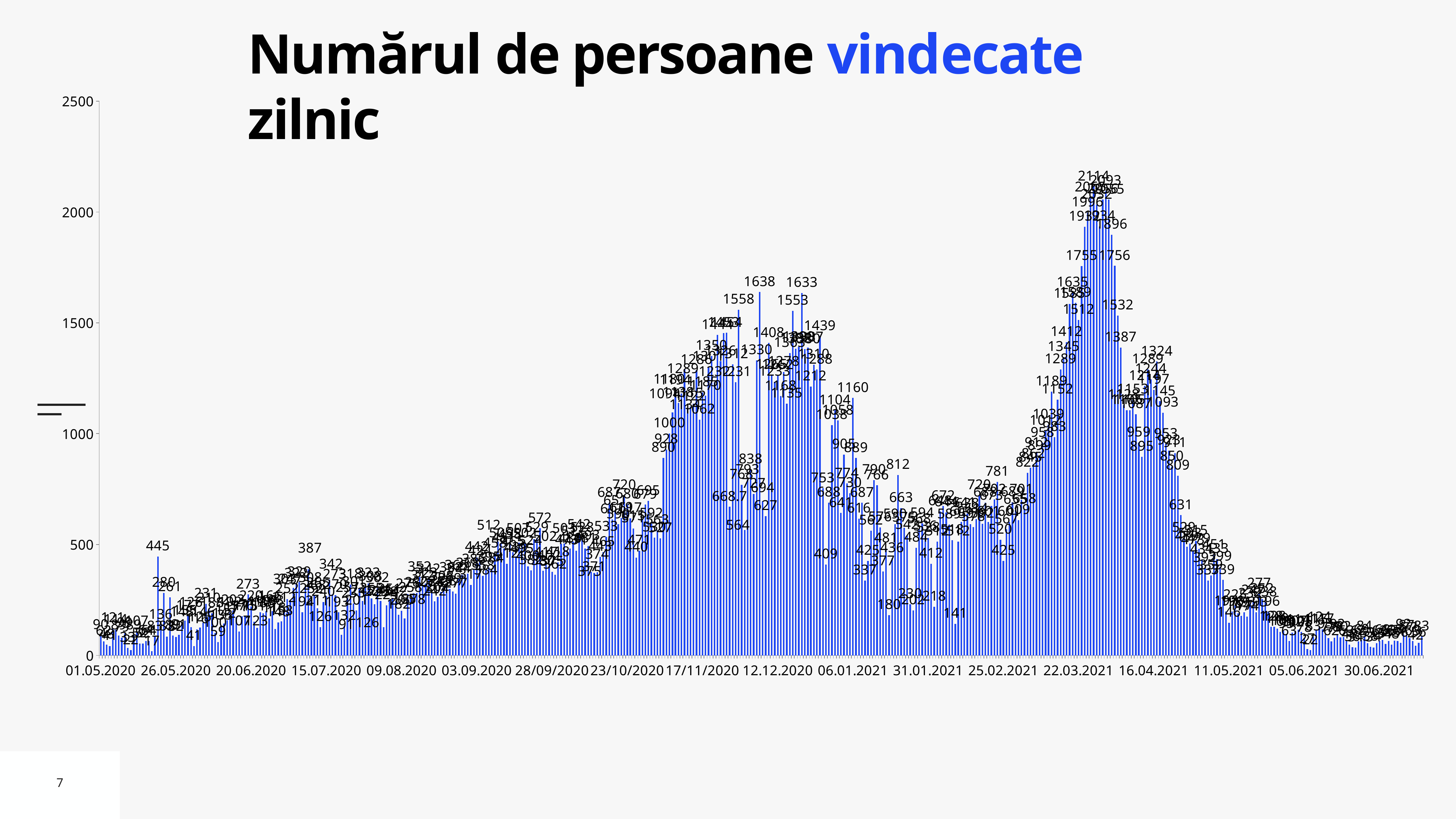
Is the highest bar on the chart greater or less than 2000? greater What is the difference between the peak value of 2114 and the December 2020 peak of 1638? 476 Is the value at 22.03.2021 greater or less than 1000? greater What kind of chart is shown on the slide? bar chart Is the value at 31.01.2021 greater or less than 1000? less Do the values generally rise or fall between 22.03.2021 and 05.06.2021? fall Do the values generally rise or fall between 01.05.2020 and 17/11/2020? rise What is the title of the chart? Numărul de persoane vindecate zilnic What is the highest value shown on the vertical axis? 2500 Which is larger, the bar labelled 1638 or the bar labelled 1633? 1638 What is the highest daily value labelled on the chart? 2114